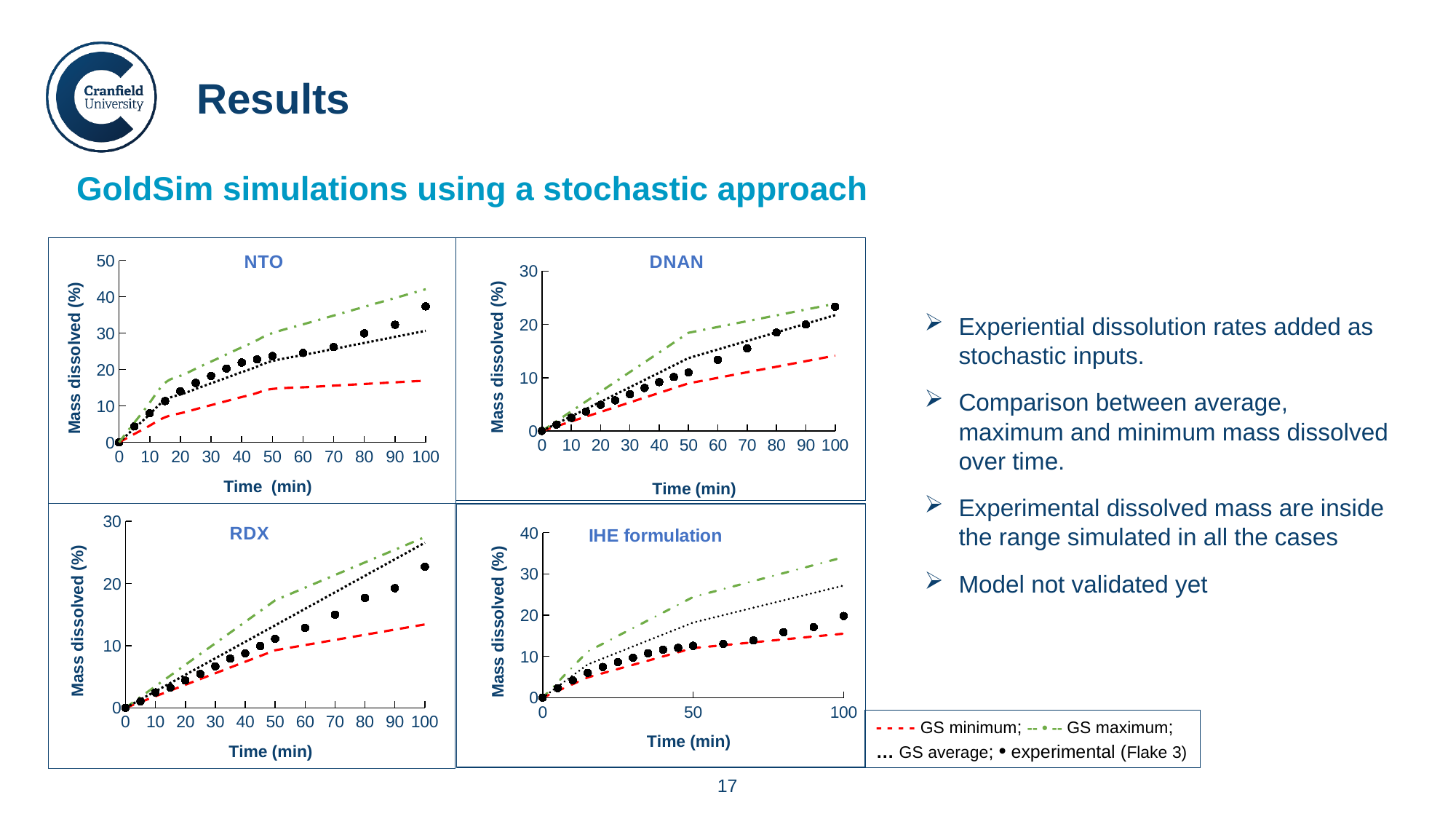
In the IHE formulation chart, is the GS maximum value at 100 min greater or less than 30? greater In the DNAN chart, is the experimental value at 100 min greater or less than 20? greater In the IHE formulation chart, which is larger at 100 min: GS average or experimental? GS average In the RDX chart, is the GS minimum value at 100 min greater or less than 20? less How many series does the legend list for the charts? 4 What is the title of the bottom-right chart? IHE formulation What kind of chart is the NTO chart? line chart What is the y-axis label on the RDX chart? Mass dissolved (%) In the NTO chart, which is larger at 100 min: GS maximum or GS minimum? GS maximum In the NTO chart, does the experimental mass dissolved rise or fall as time increases? rise